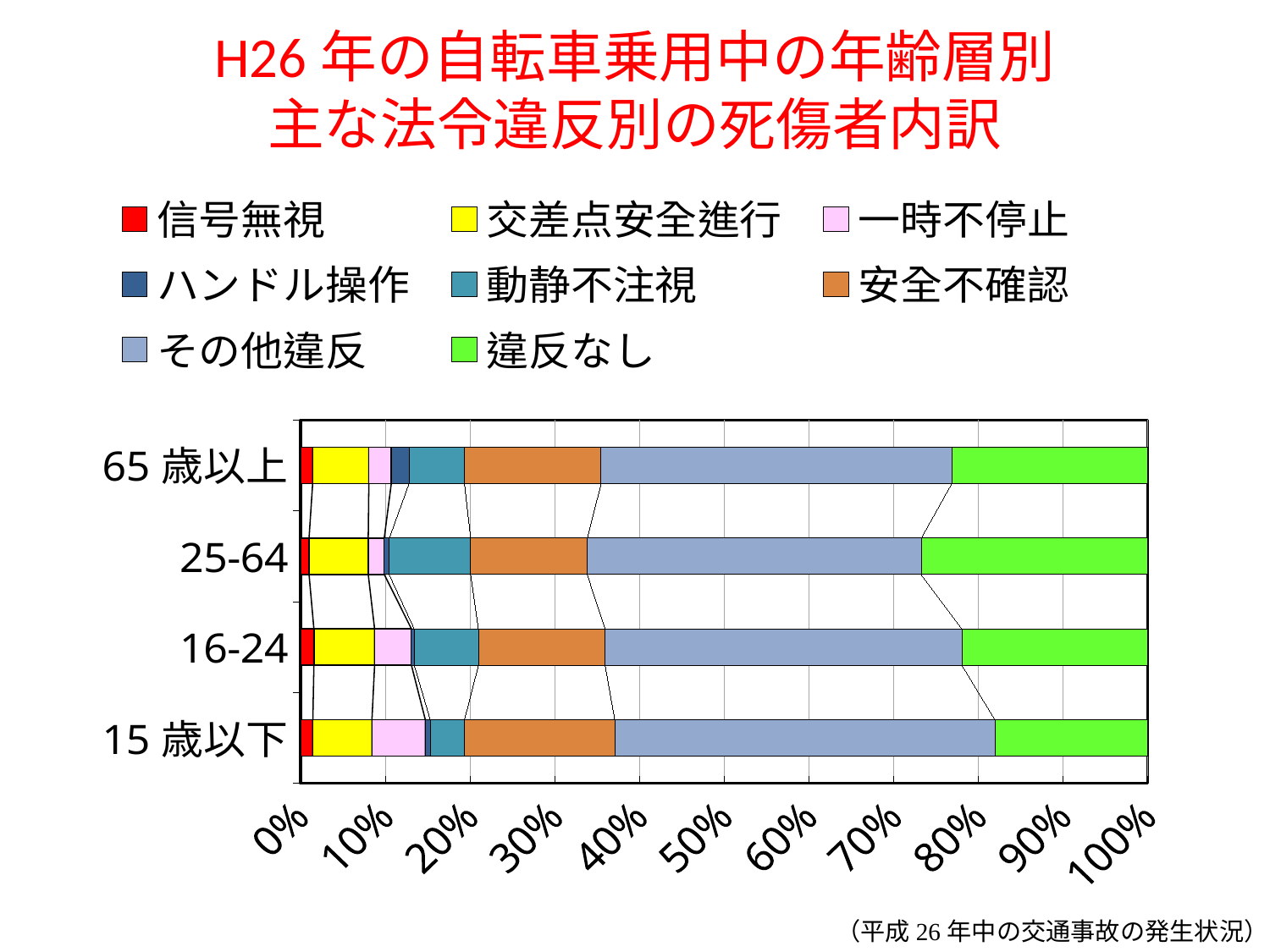
How many series does the legend list? 8 Is the share of 信号無視 for 16-24 greater or less than 10%? less What kind of chart is shown on the slide? stacked bar chart How many age-group categories are plotted on the chart? 4 Is the share of その他違反 for 25-64 greater or less than 30%? greater Which age group has the largest share of 違反なし? 25-64 Which age group has the larger share of 違反なし, 25-64 or 15歳以下? 25-64 Which age group has the larger share of 一時不停止, 15歳以下 or 65歳以上? 15歳以下 Is the share of 安全不確認 for 65歳以上 greater or less than 10%? greater Which age group has the smallest share of 違反なし? 15歳以下 What colour represents 違反なし in the legend? green